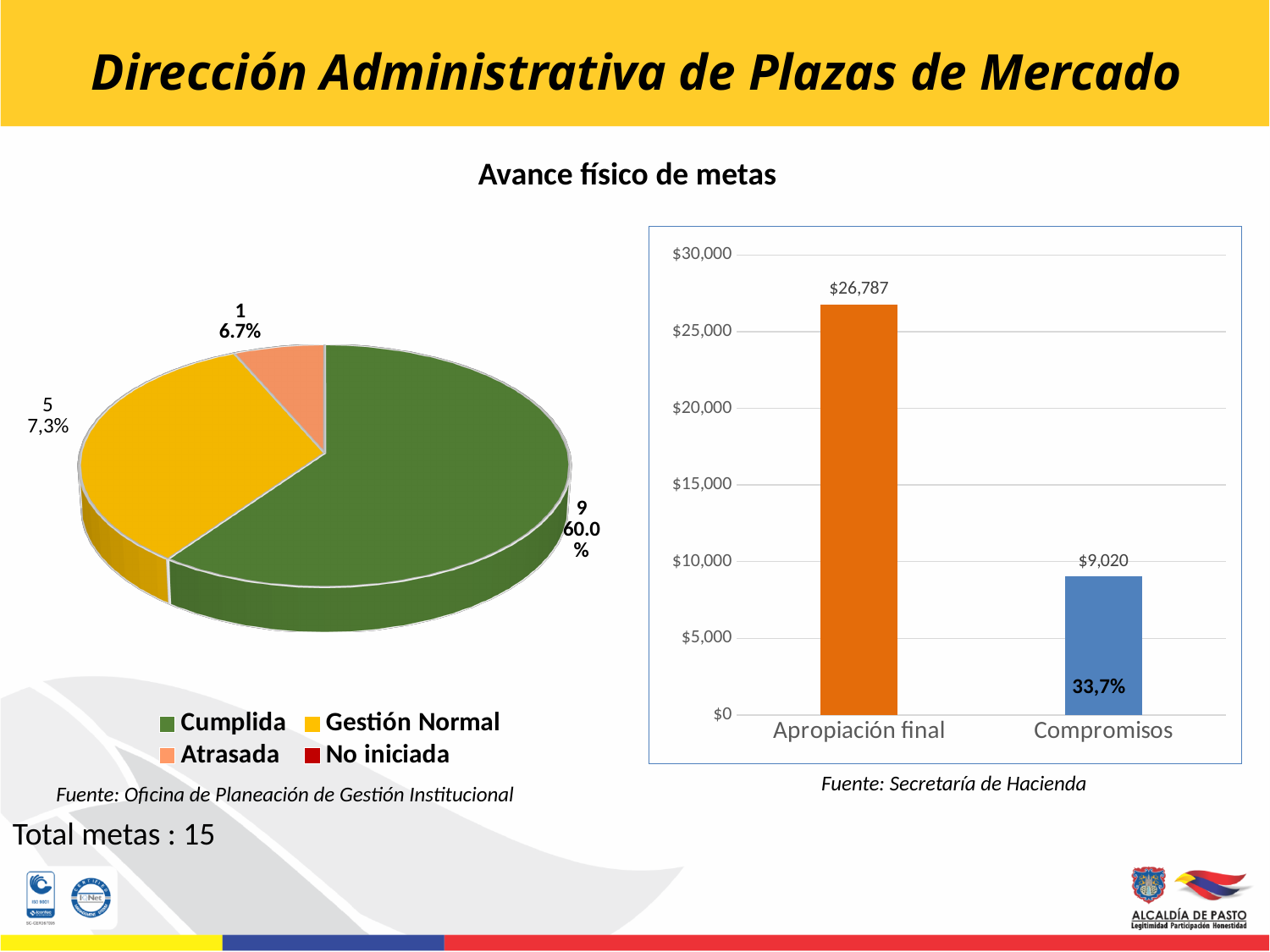
In the pie chart 'Avance físico de metas', how many metas are labelled Cumplida? 9 In the right bar chart, what is the value for Compromisos? $9,020 In the pie chart 'Avance físico de metas', what percentage share does the Atrasada slice show? 6.7% In the pie chart 'Avance físico de metas', which category has the largest slice? Cumplida In the right bar chart, what is the difference between Apropiación final and Compromisos? $17,767 In the pie chart 'Avance físico de metas', what percentage share does the Cumplida slice show? 60.0% What kind of chart is the left chart titled 'Avance físico de metas'? pie chart In the pie chart 'Avance físico de metas', how many metas are labelled Atrasada? 1 What kind of chart is the right chart showing Apropiación final and Compromisos? bar chart In the right bar chart, what is the value for Apropiación final? $26,787 In the pie chart 'Avance físico de metas', how many metas are labelled Gestión Normal? 5 How many entries does the legend of the pie chart 'Avance físico de metas' list? 4